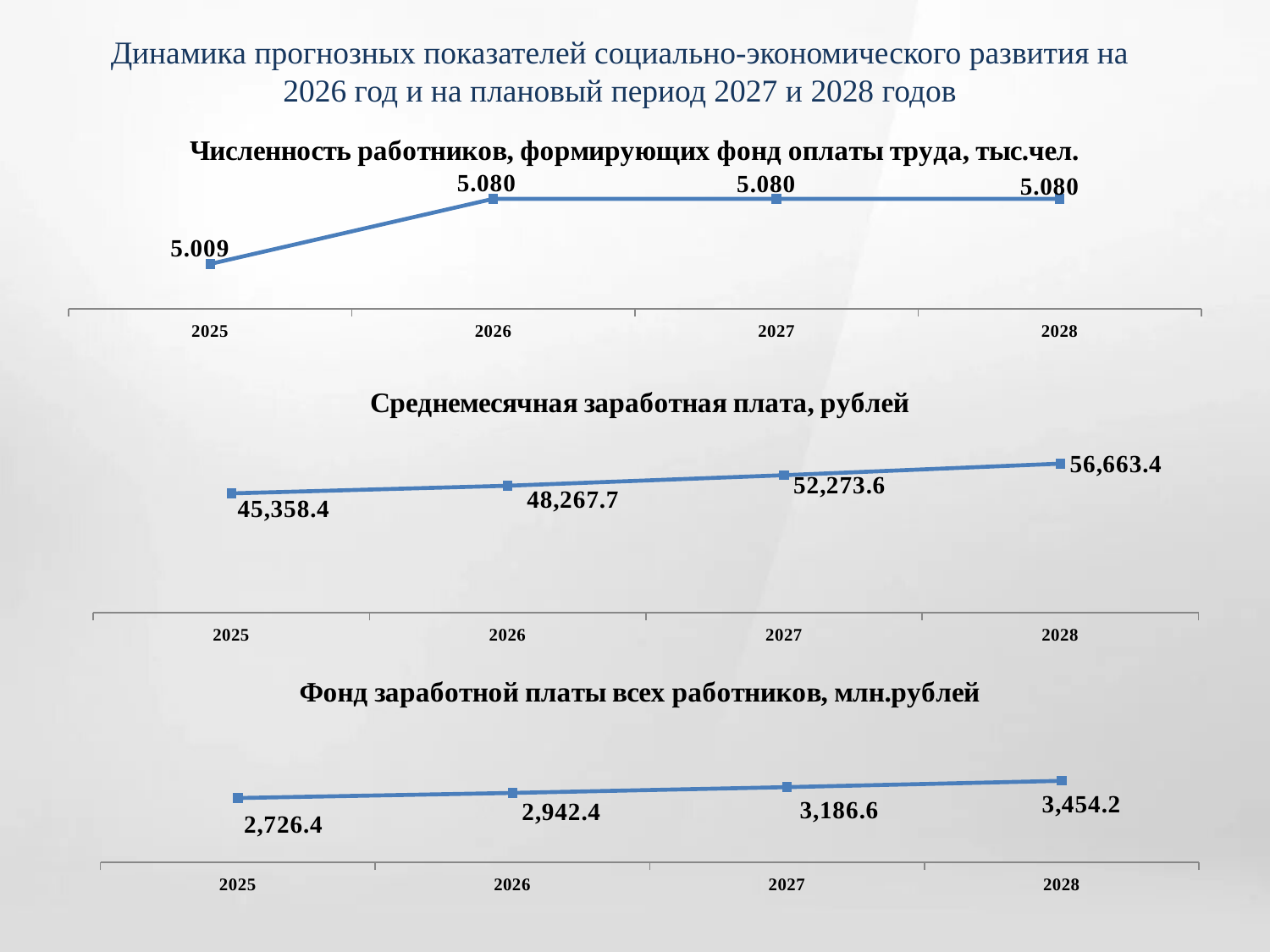
In the chart titled "Фонд заработной платы всех работников, млн.рублей", what is the value for 2026? 2,942.4 In the chart titled "Среднемесячная заработная плата, рублей", do the values rise or fall from 2025 to 2028? rise In the chart titled "Среднемесячная заработная плата, рублей", which year has the highest value? 2028 In the chart titled "Фонд заработной платы всех работников, млн.рублей", which is larger, the value for 2027 or the value for 2025? 2027 What kind of chart is the top chart on the slide? line chart In the chart titled "Численность работников, формирующих фонд оплаты труда, тыс.чел.", which year has the lowest value? 2025 In the chart titled "Среднемесячная заработная плата, рублей", what is the value for 2027? 52,273.6 In the chart titled "Численность работников, формирующих фонд оплаты труда, тыс.чел.", what is the value for 2025? 5.009 In the chart titled "Среднемесячная заработная плата, рублей", what is the difference between the 2028 value and the 2025 value? 11,305.0 In the chart titled "Фонд заработной платы всех работников, млн.рублей", what is the difference between the 2028 value and the 2025 value? 727.8 In the chart titled "Численность работников, формирующих фонд оплаты труда, тыс.чел.", what is the difference between the 2026 value and the 2025 value? 0.071 How many years are plotted in the chart titled "Фонд заработной платы всех работников, млн.рублей"? 4